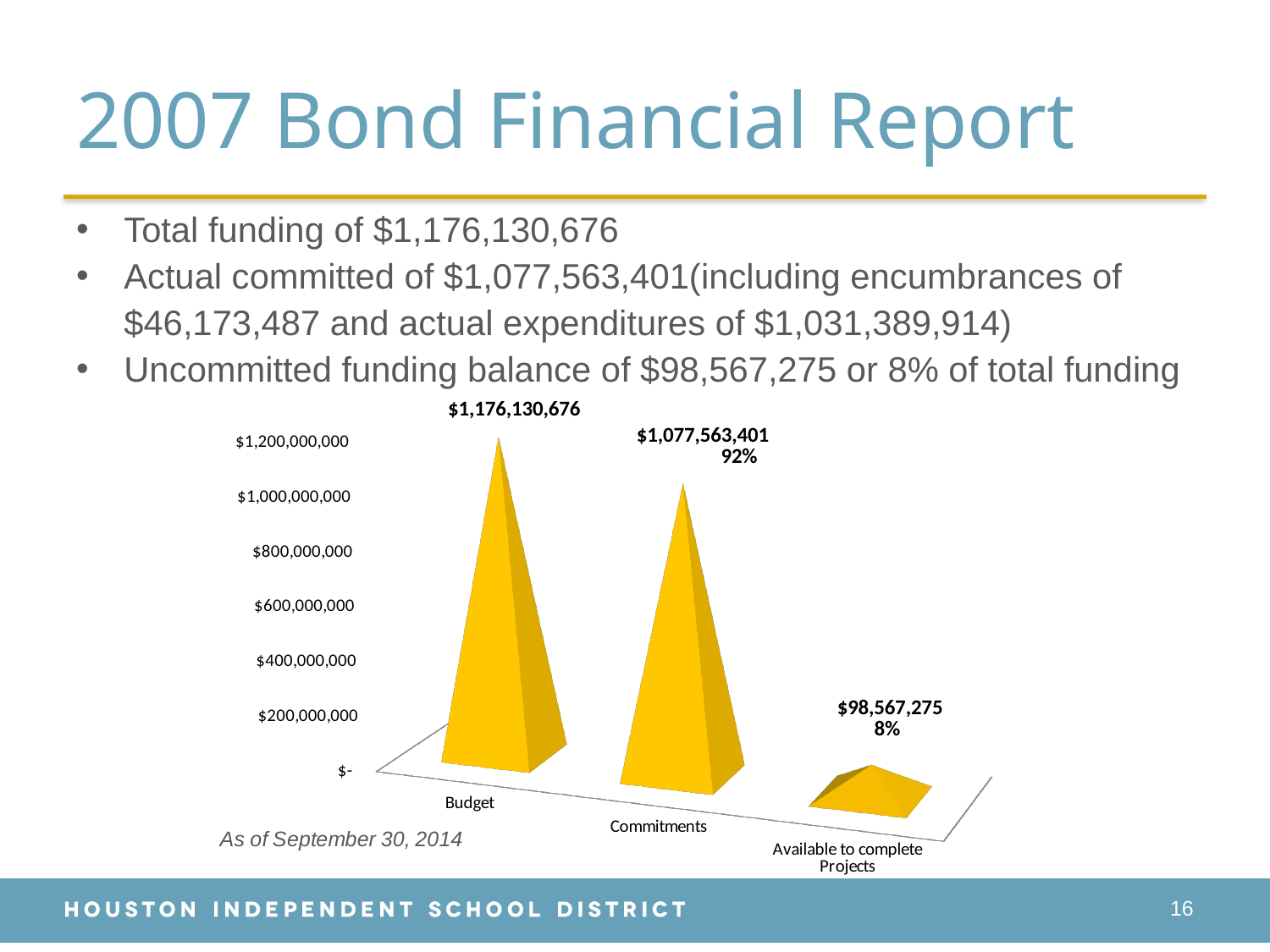
What is the value of the Available to complete Projects bar? $98,567,275 What is the difference between the Budget and Commitments values? $98,567,275 What is the difference between the Commitments and Available to complete Projects values? $978,996,126 Which category has the lowest value? Available to complete Projects What kind of chart is shown on the slide? Bar chart What is the value of the Budget bar? $1,176,130,676 Which is larger, Commitments or Available to complete Projects? Commitments What is the value of the Commitments bar? $1,077,563,401 Which category has the highest value? Budget How many categories are shown in the chart? 3 What percentage is shown above the Available to complete Projects bar? 8% What percentage is shown above the Commitments bar? 92%